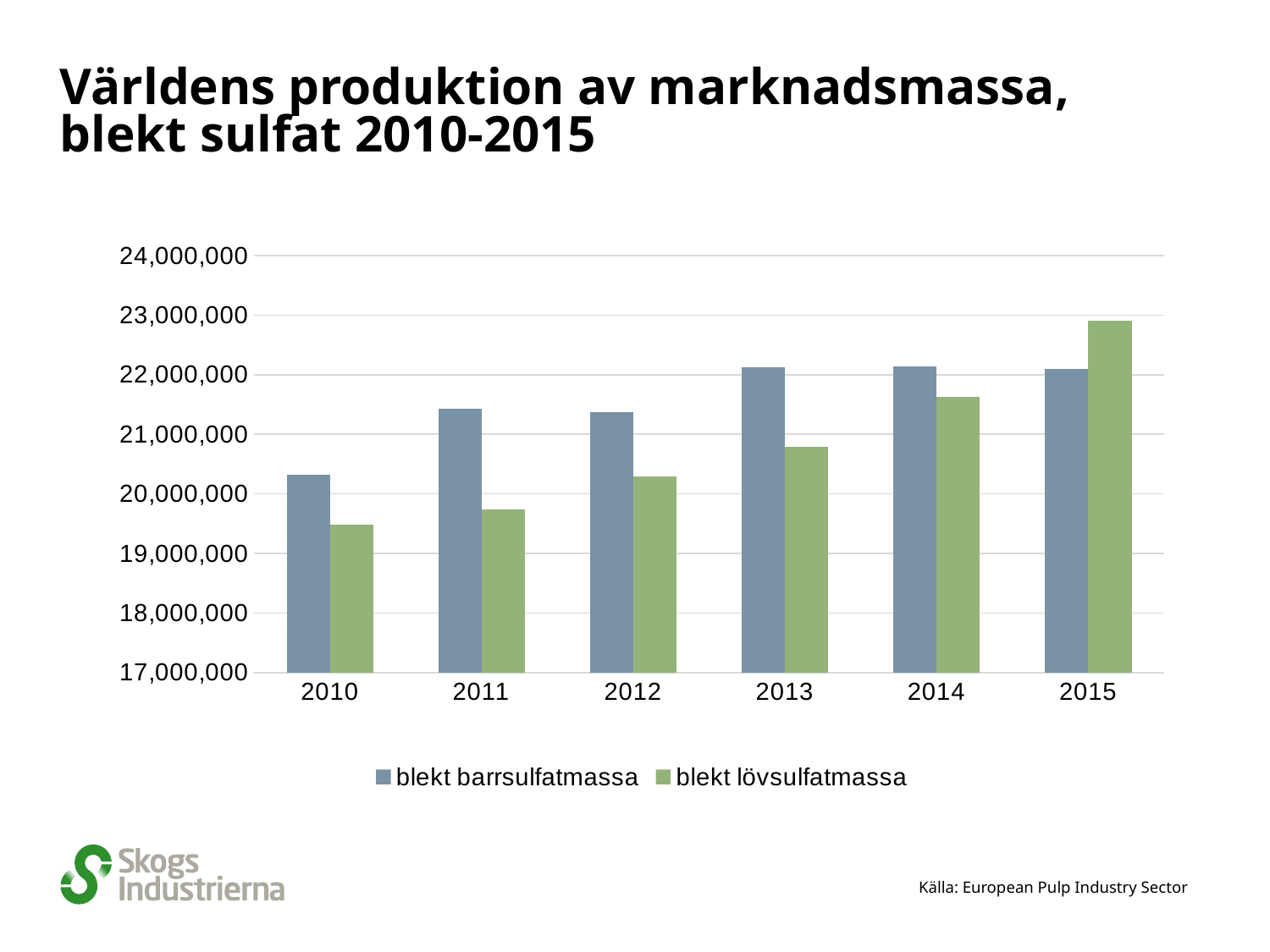
In which year is the value for blekt lövsulfatmassa highest? 2015 What source is cited for the chart? European Pulp Industry Sector How many years are shown on the x axis? 6 What kind of chart is shown on the slide? bar chart In 2010, which series has the larger value, blekt barrsulfatmassa or blekt lövsulfatmassa? blekt barrsulfatmassa Does the value for blekt lövsulfatmassa rise or fall from 2010 to 2015? rise How many series does the legend list? 2 Is the value for blekt lövsulfatmassa in 2015 greater or less than 22,000,000? greater In which year is the value for blekt barrsulfatmassa lowest? 2010 Is the value for blekt lövsulfatmassa in 2010 greater or less than 20,000,000? less In 2015, which series has the larger value, blekt barrsulfatmassa or blekt lövsulfatmassa? blekt lövsulfatmassa In which year is the value for blekt lövsulfatmassa lowest? 2010